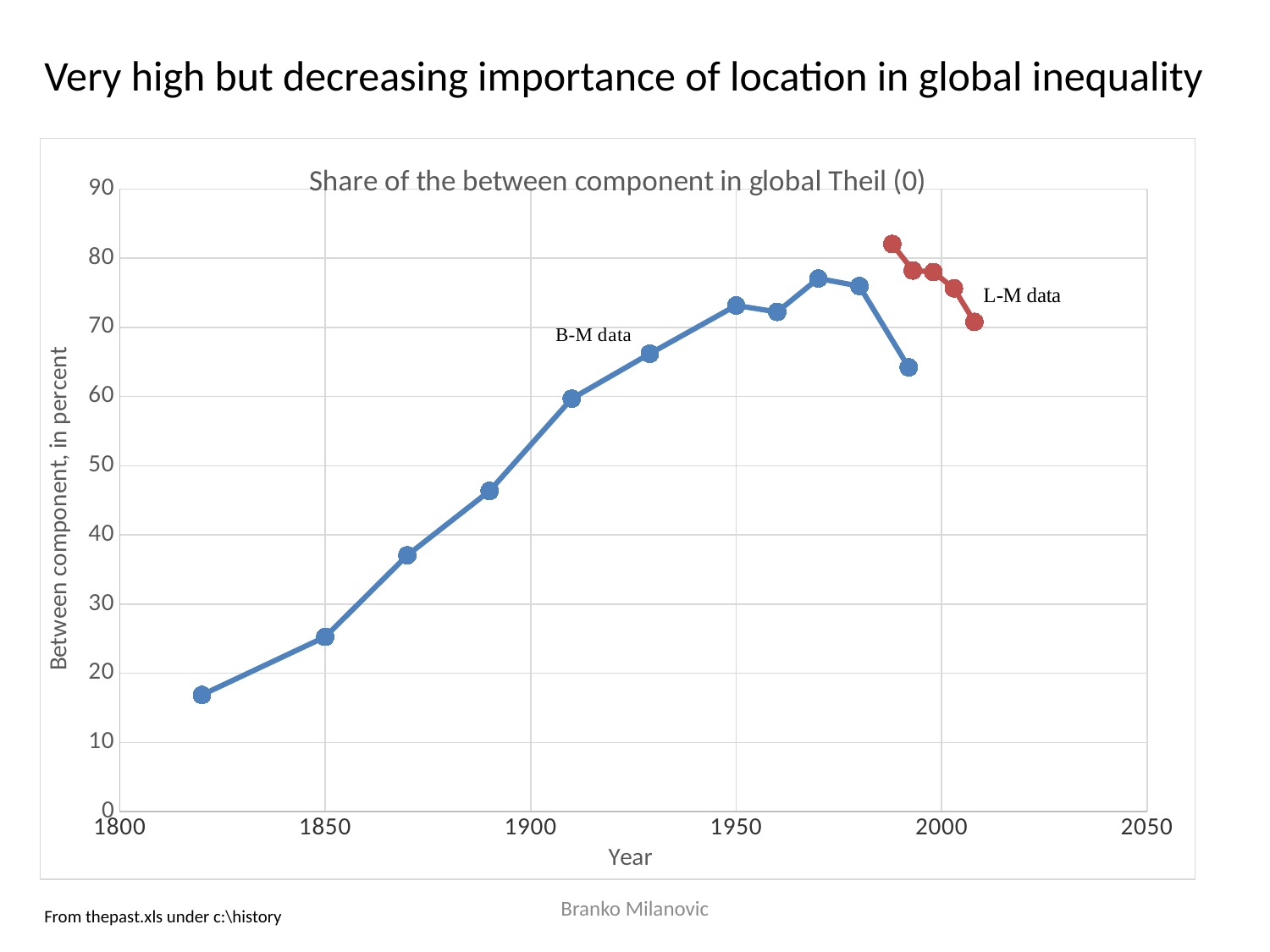
Which series reaches the higher value: B-M data or L-M data? L-M data What is the label of the vertical axis? Between component, in percent How many data points does the B-M data series have? 11 Is the last value of the L-M data series (around 2008) greater or less than 80? less Do the values of the L-M data series rise or fall over time? fall What kind of chart is shown on the slide? line chart Is the first value of the L-M data series (around 1988) greater or less than 80? greater Is the value of the B-M data series at 1820 greater or less than 20? less How many data points does the L-M data series have? 5 Do the values of the B-M data series rise or fall between 1820 and 1970? rise What is the title of the chart? Share of the between component in global Theil (0)